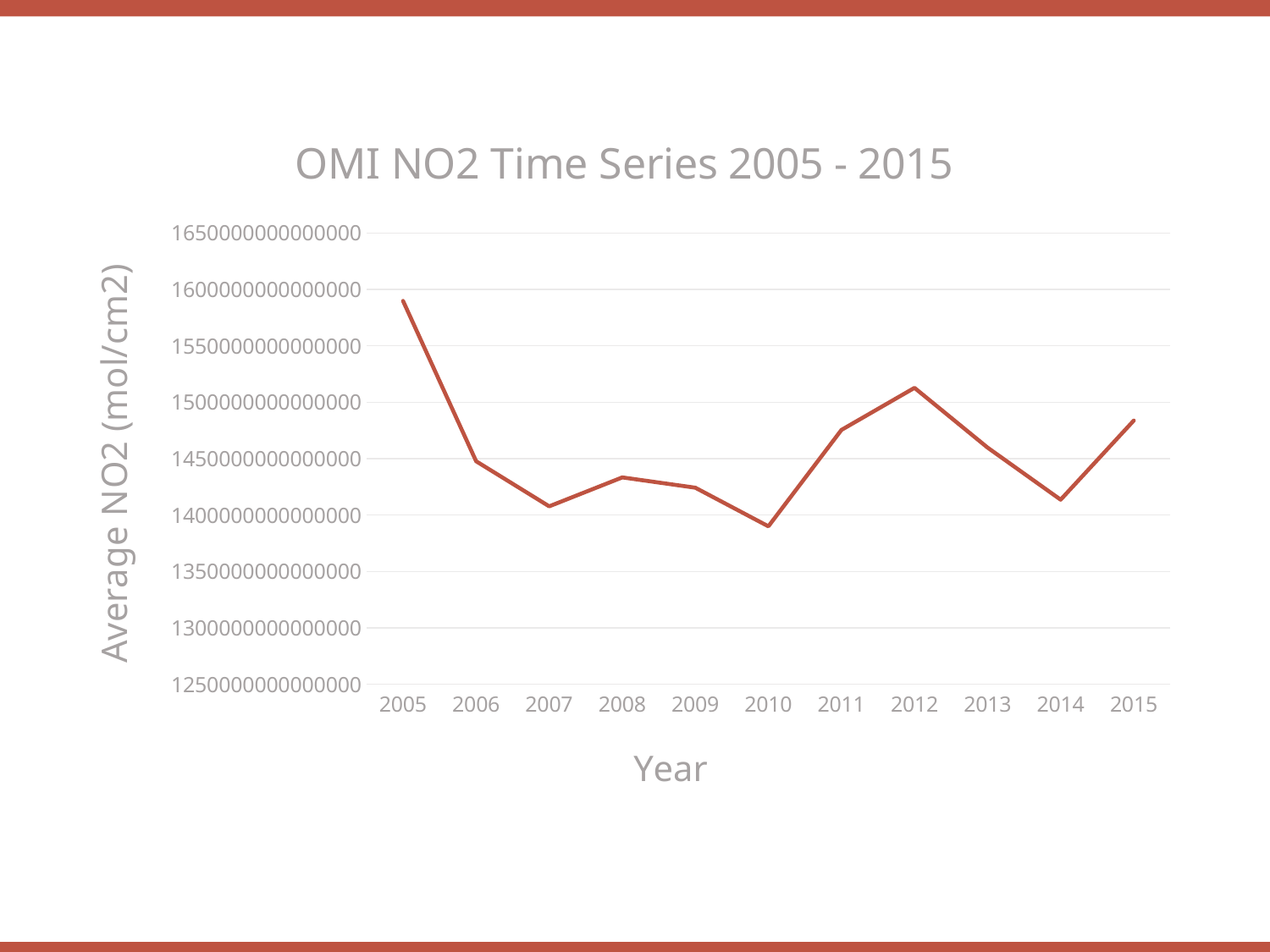
Is the value for 2012 greater or less than 1500000000000000? greater Is the value for 2008 greater or less than 1450000000000000? less What is the label of the y axis? Average NO2 (mol/cm2) Does the average NO2 value rise or fall from 2010 to 2012? Rise What kind of chart is shown on the slide? Line chart What is the title of the chart? OMI NO2 Time Series 2005 - 2015 Is the value for 2010 greater or less than 1400000000000000? less How many years are plotted on the x axis? 11 Which year has the larger value, 2012 or 2013? 2012 Which year has the lowest average NO2 value? 2010 Which year has the highest average NO2 value? 2005